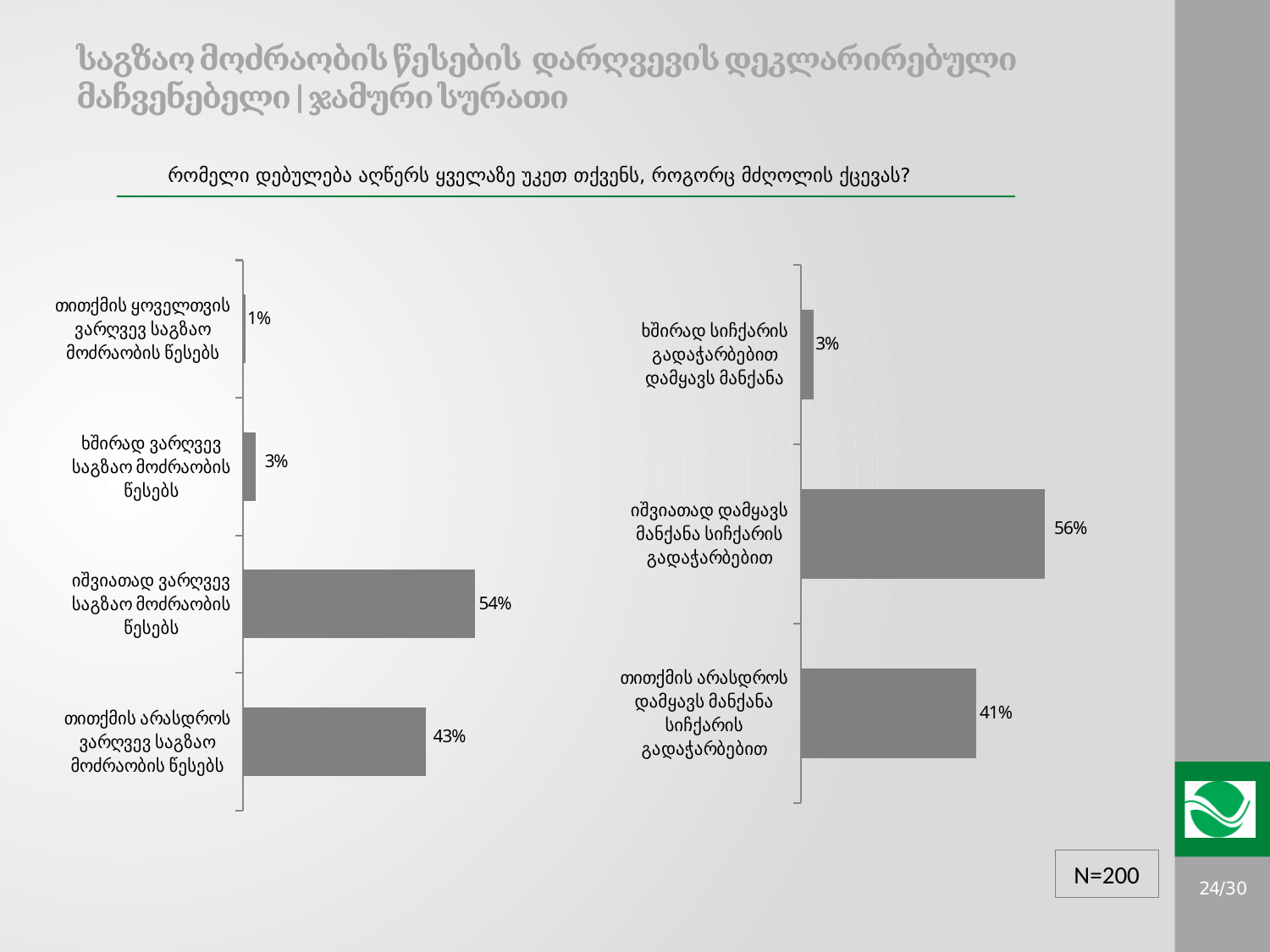
What kind of chart is the right chart? Bar chart In the left chart, what is the value for "იშვიათად ვარღვევ საგზაო მოძრაობის წესებს"? 54% In the left chart, what is the value for "თითქმის ყოველთვის ვარღვევ საგზაო მოძრაობის წესებს"? 1% In the left chart, which category has the lowest value? თითქმის ყოველთვის ვარღვევ საგზაო მოძრაობის წესებს In the right chart, what is the value for "თითქმის არასდროს დამყავს მანქანა სიჩქარის გადაჭარბებით"? 41% What sample size (N) is shown on the slide? N=200 In the right chart, what is the difference between "იშვიათად დამყავს მანქანა სიჩქარის გადაჭარბებით" and "ხშირად სიჩქარის გადაჭარბებით დამყავს მანქანა"? 53% How many categories does the left chart show? 4 In the right chart, which category has the highest value? იშვიათად დამყავს მანქანა სიჩქარის გადაჭარბებით In the left chart, what is the difference between "იშვიათად ვარღვევ საგზაო მოძრაობის წესებს" and "თითქმის არასდროს ვარღვევ საგზაო მოძრაობის წესებს"? 11% How many categories does the right chart show? 3 In the left chart, which is larger: "ხშირად ვარღვევ საგზაო მოძრაობის წესებს" or "თითქმის არასდროს ვარღვევ საგზაო მოძრაობის წესებს"? თითქმის არასდროს ვარღვევ საგზაო მოძრაობის წესებს